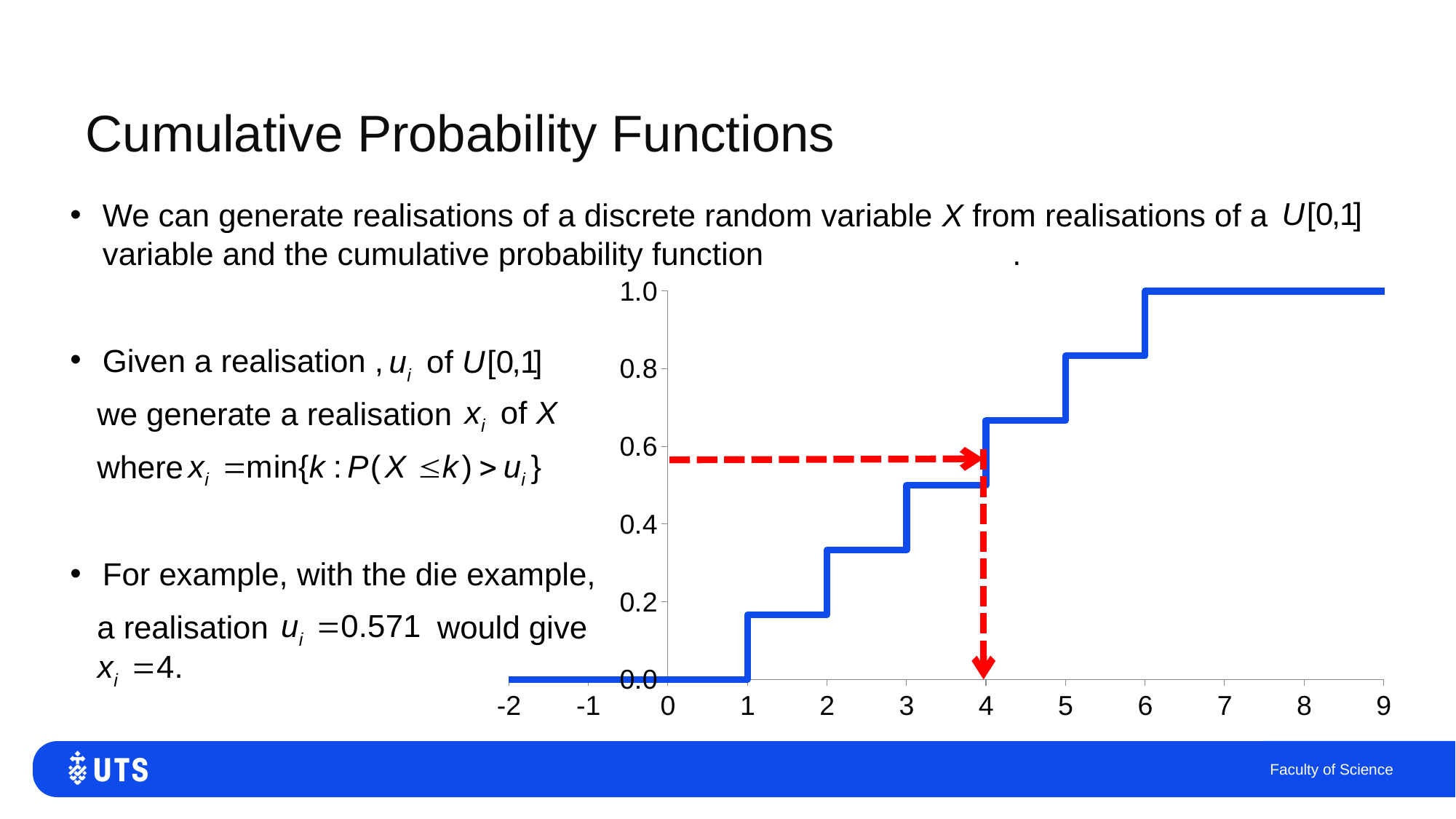
Do the values of the blue step function rise or fall as x increases along the x axis? rise Is the value of the step function at x = 2 greater or less than 0.4? less Which is larger, the value of the step function at x = 2 or at x = 5? x = 5 What is the value of the blue step function at x = 7? 1.0 What kind of chart is shown on the slide? line chart (step function) Is the value of the step function at x = 3 greater or less than 0.6? less What is the value of the blue step function at x = -1? 0.0 At which x-axis value does the red dashed vertical arrow point? 4 Is the value of the step function at x = 1 greater or less than 0.2? less How many tick labels are shown on the x axis of the chart? 12